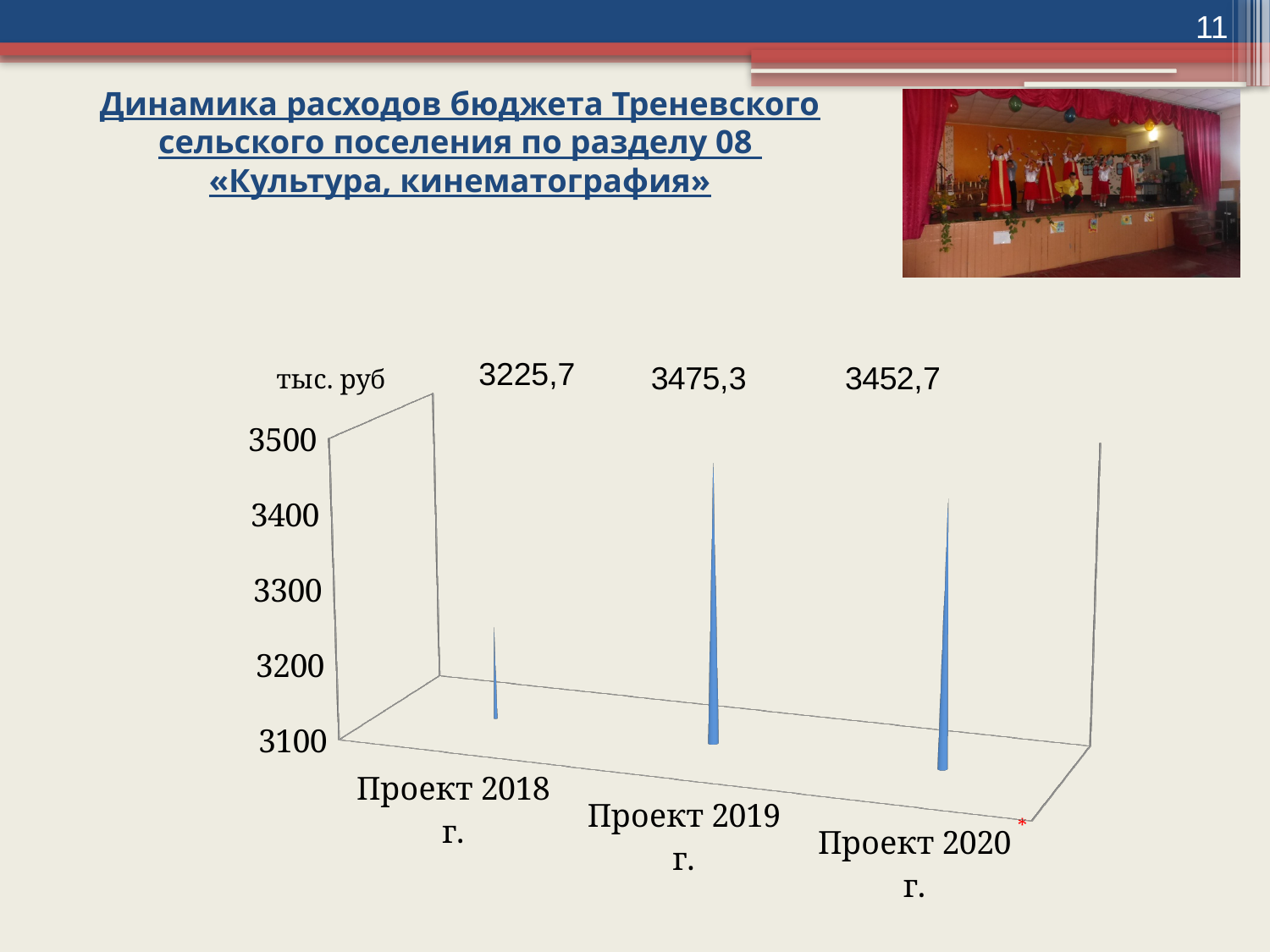
Is the value for Проект 2018 г. greater or less than 3300? less Which category has the lowest value? Проект 2018 г. How many categories are shown on the x axis? 3 What kind of chart is shown on the slide? bar chart What is the difference between the values for Проект 2019 г. and Проект 2020 г.? 22,6 What is the value for Проект 2018 г.? 3225,7 What is the difference between the values for Проект 2019 г. and Проект 2018 г.? 249,6 What is the value for Проект 2020 г.? 3452,7 What unit is indicated at the top of the vertical axis? тыс. руб Which is larger, the value for Проект 2020 г. or the value for Проект 2018 г.? Проект 2020 г. Which category has the highest value? Проект 2019 г. What is the value for Проект 2019 г.? 3475,3